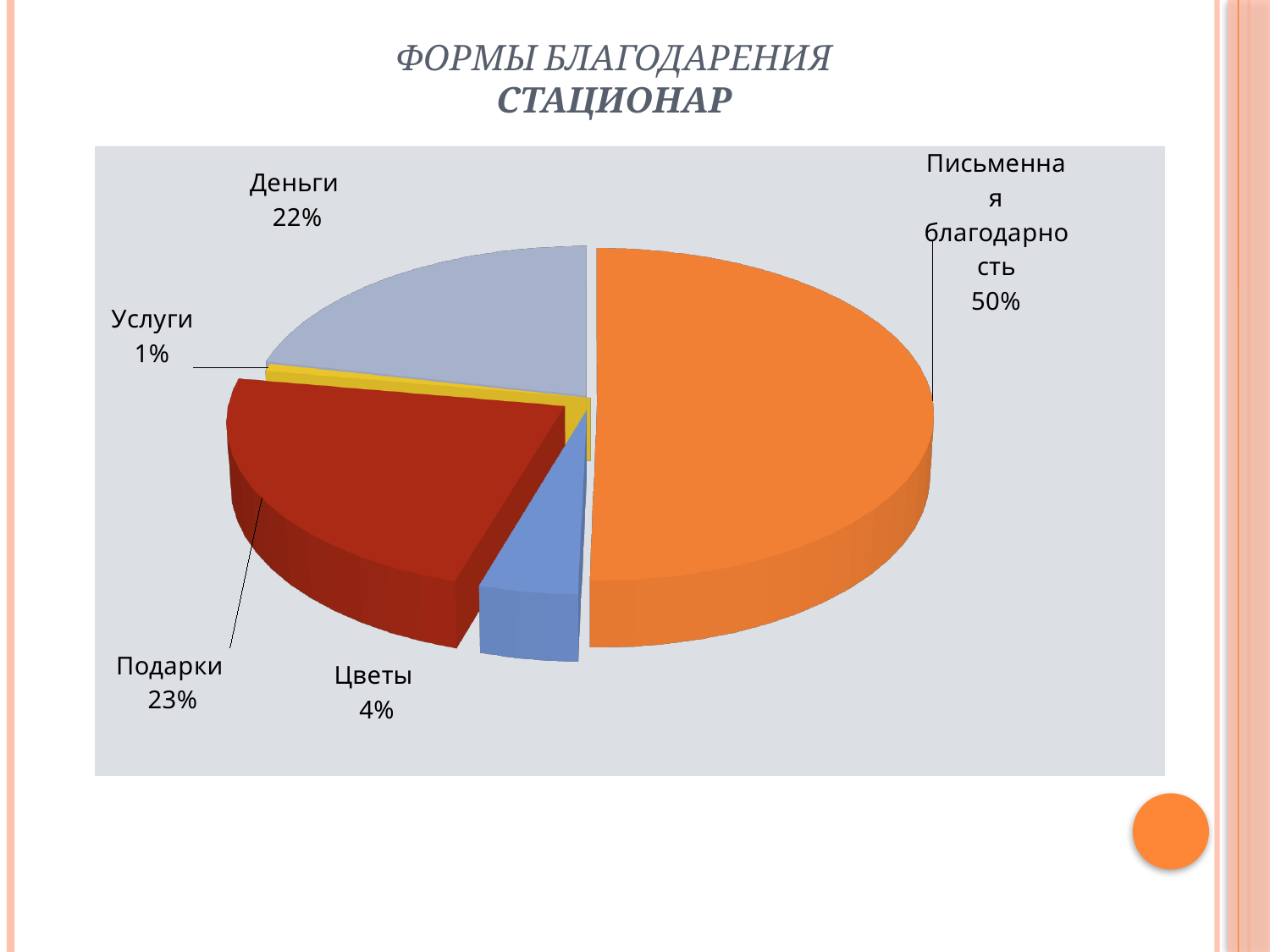
What is the value for Подарки? 23% What is the value for Услуги? 1% What is the title of the slide? ФОРМЫ БЛАГОДАРЕНИЯ СТАЦИОНАР What is the value for Деньги? 22% What is the difference between the shares of Подарки and Цветы? 19% What kind of chart is shown on the slide? Pie chart How many categories are shown in the pie chart? 5 Which is larger, the share for Деньги or the share for Цветы? Деньги What is the value for Цветы? 4% Which category has the smallest share of the pie? Услуги What share of the pie does Письменная благодарность have? 50% Which category has the largest share of the pie? Письменная благодарность